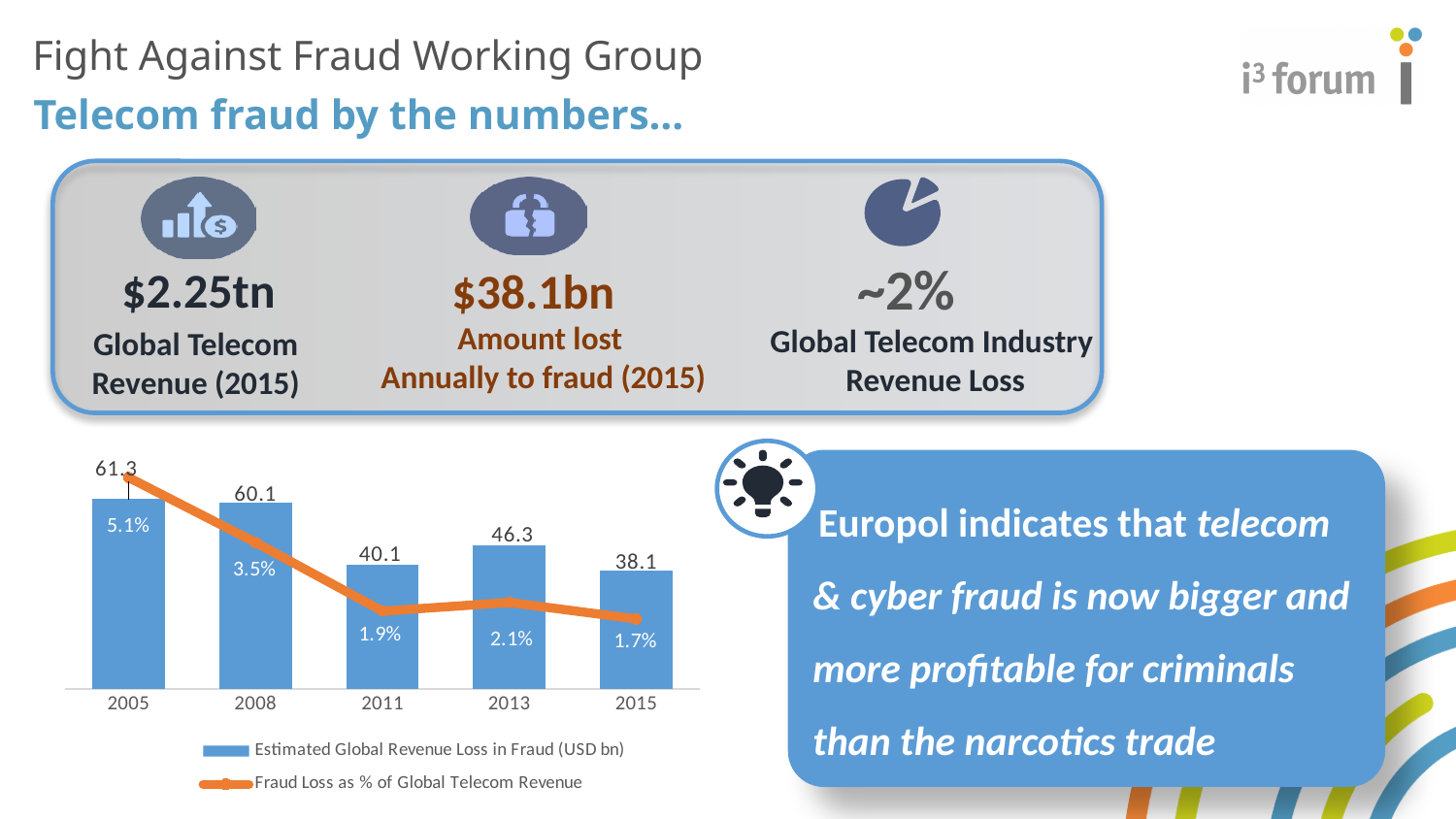
Which year has the highest Estimated Global Revenue Loss in Fraud (USD bn)? 2005 What is the Estimated Global Revenue Loss in Fraud (USD bn) for 2015? 38.1 Does the Fraud Loss as % of Global Telecom Revenue generally rise or fall from 2005 to 2015? Fall Which year has a larger Estimated Global Revenue Loss in Fraud (USD bn), 2011 or 2013? 2013 What kind of chart is shown on the slide? Combined bar and line chart What colour are the bars for Estimated Global Revenue Loss in Fraud (USD bn)? Blue What is the difference in Estimated Global Revenue Loss in Fraud (USD bn) between 2005 and 2015? 23.2 Which year has the lowest Fraud Loss as % of Global Telecom Revenue? 2015 How many years are shown on the x axis of the chart? 5 What is the Estimated Global Revenue Loss in Fraud (USD bn) for 2005? 61.3 How many series does the chart legend list? 2 What is the Fraud Loss as % of Global Telecom Revenue for 2013? 2.1%